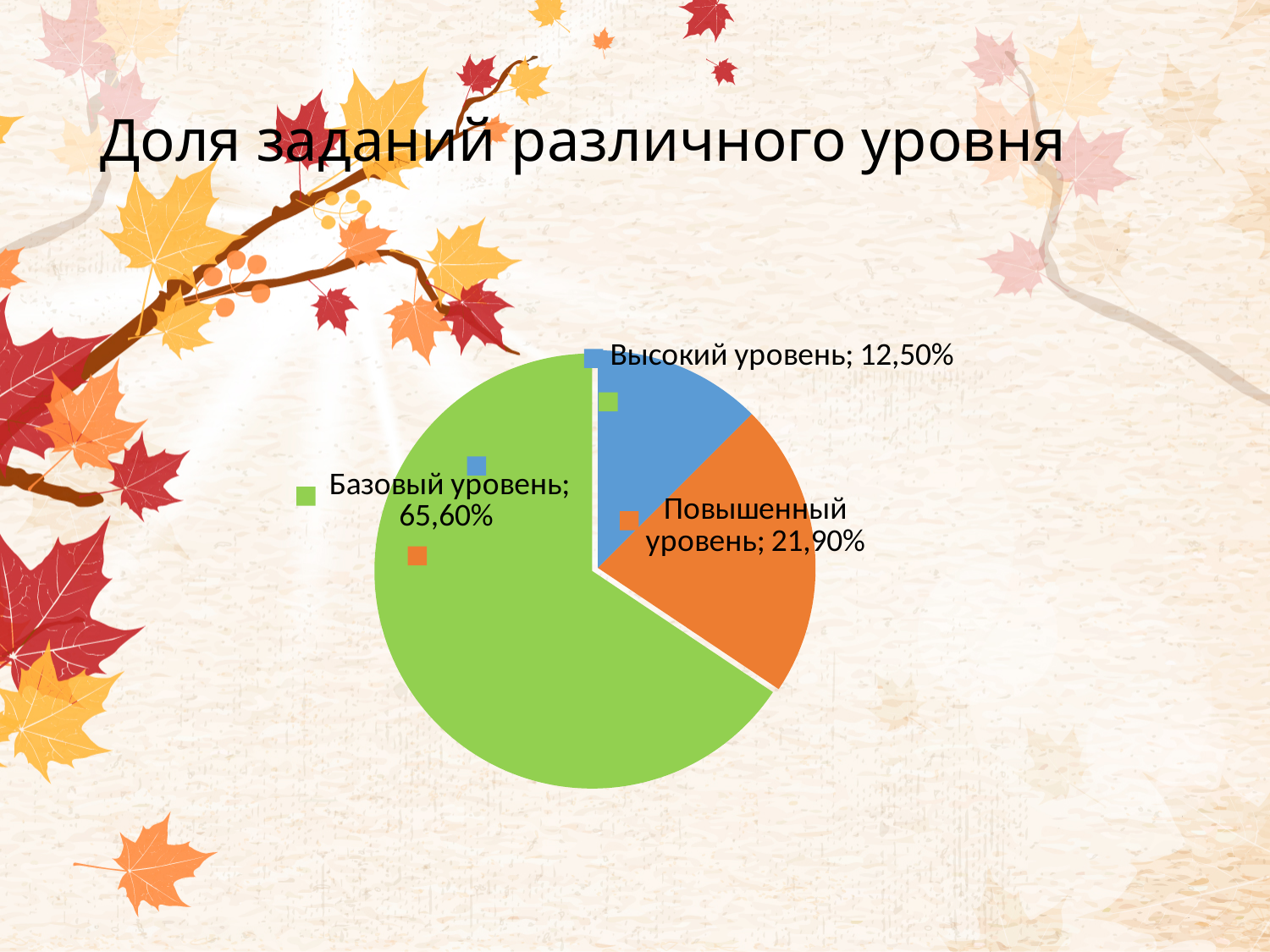
What share of the pie does Базовый уровень have? 65,60% What colour is the slice for Базовый уровень? Green Which category has the smallest slice of the pie? Высокий уровень What is the title of the chart on the slide? Доля заданий различного уровня What is the difference in percentage points between Повышенный уровень and Высокий уровень? 9,40 Which category has the largest slice of the pie? Базовый уровень What is the difference in percentage points between Базовый уровень and Повышенный уровень? 43,70 Which is larger, the slice for Повышенный уровень or the slice for Высокий уровень? Повышенный уровень What share of the pie does Высокий уровень have? 12,50% How many slices does the pie chart have? 3 What share of the pie does Повышенный уровень have? 21,90% What kind of chart is shown on the slide? Pie chart